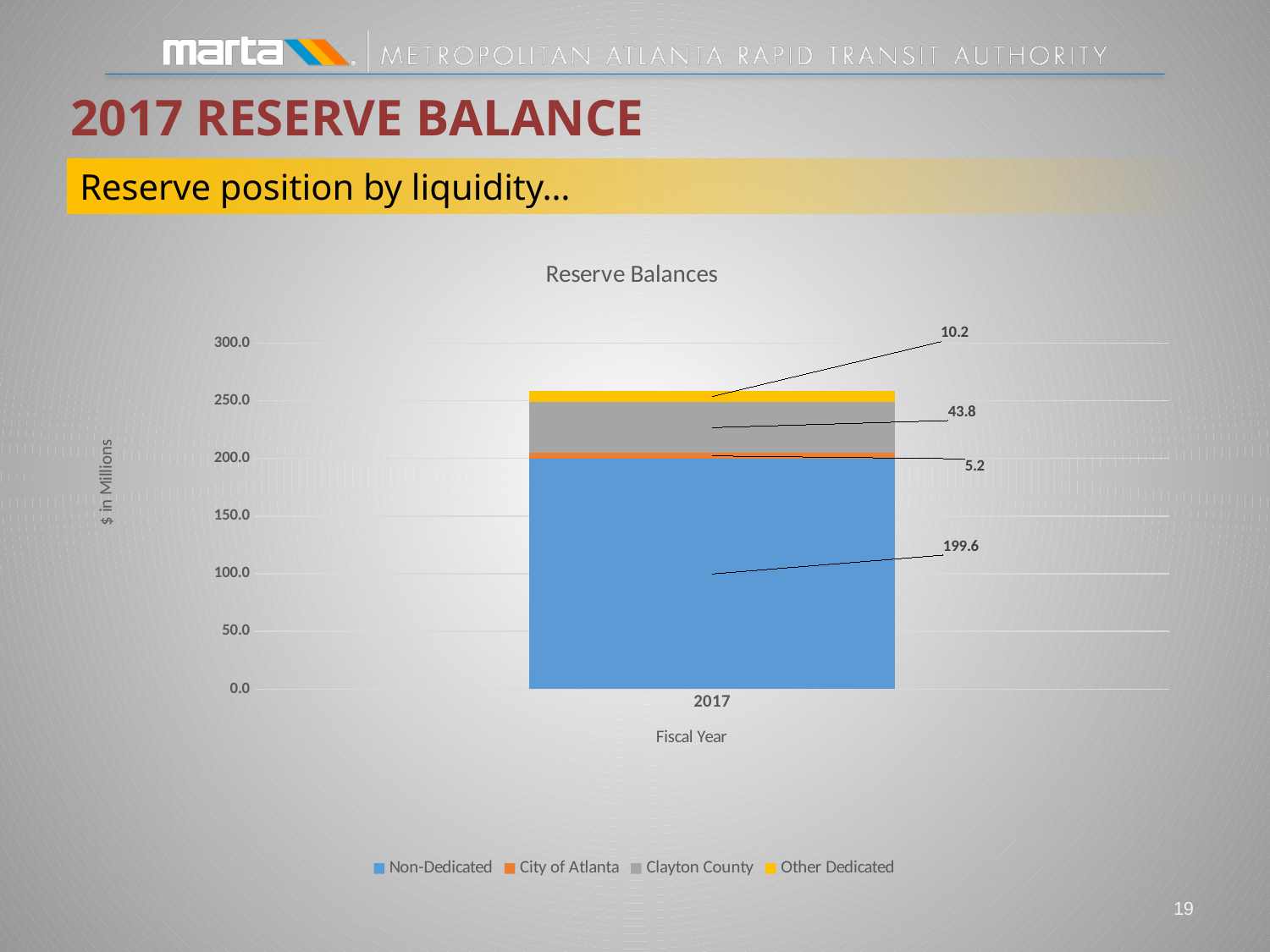
What is the value for Other Dedicated in 2017? 10.2 Which series has the largest value in the 2017 bar? Non-Dedicated How many series does the legend list? 4 What kind of chart is shown? Stacked bar chart What is the total of the stacked bar for 2017? 258.8 What is the value for Non-Dedicated in 2017? 199.6 Which is larger in 2017, Clayton County or Other Dedicated? Clayton County Which series has the smallest value in the 2017 bar? City of Atlanta What is the value for City of Atlanta in 2017? 5.2 What is the title of the chart? Reserve Balances What is the value for Clayton County in 2017? 43.8 What is the difference between the Clayton County and Other Dedicated values in 2017? 33.6